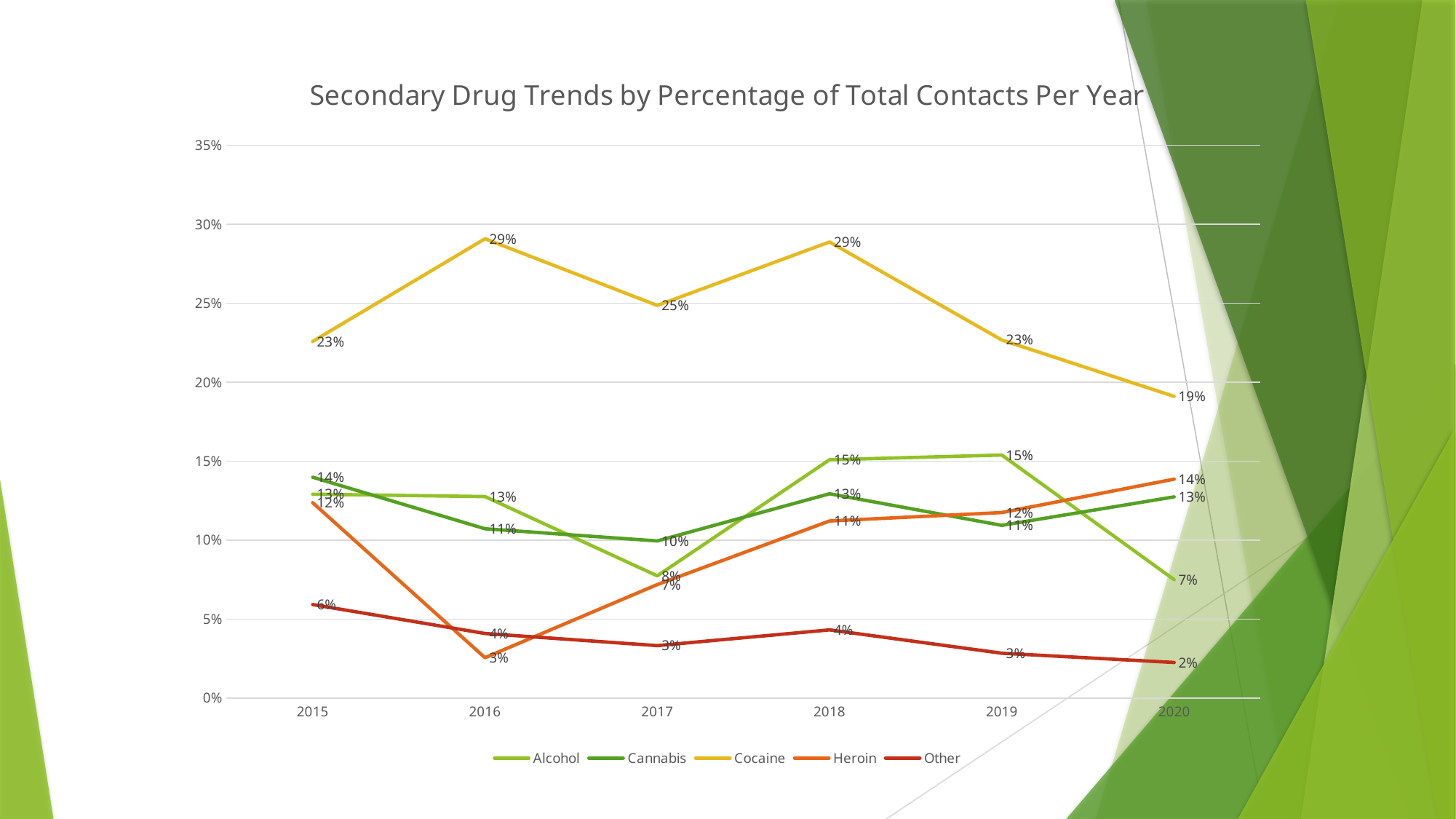
How many series does the legend list? 5 What is the value for Heroin in 2016? 3% What is the value for Alcohol in 2020? 7% Which series has the highest value in 2018? Cocaine What is the value for Cocaine in 2017? 25% What is the difference between the Cocaine values in 2016 and 2020? 10% Does the Other series rise or fall from 2015 to 2020? Fall Which series has the lowest value in 2020? Other What is the title of the chart? Secondary Drug Trends by Percentage of Total Contacts Per Year What type of chart is shown on the slide? Line chart Which is larger in 2019, Alcohol or Cannabis? Alcohol How many years are shown on the x axis? 6